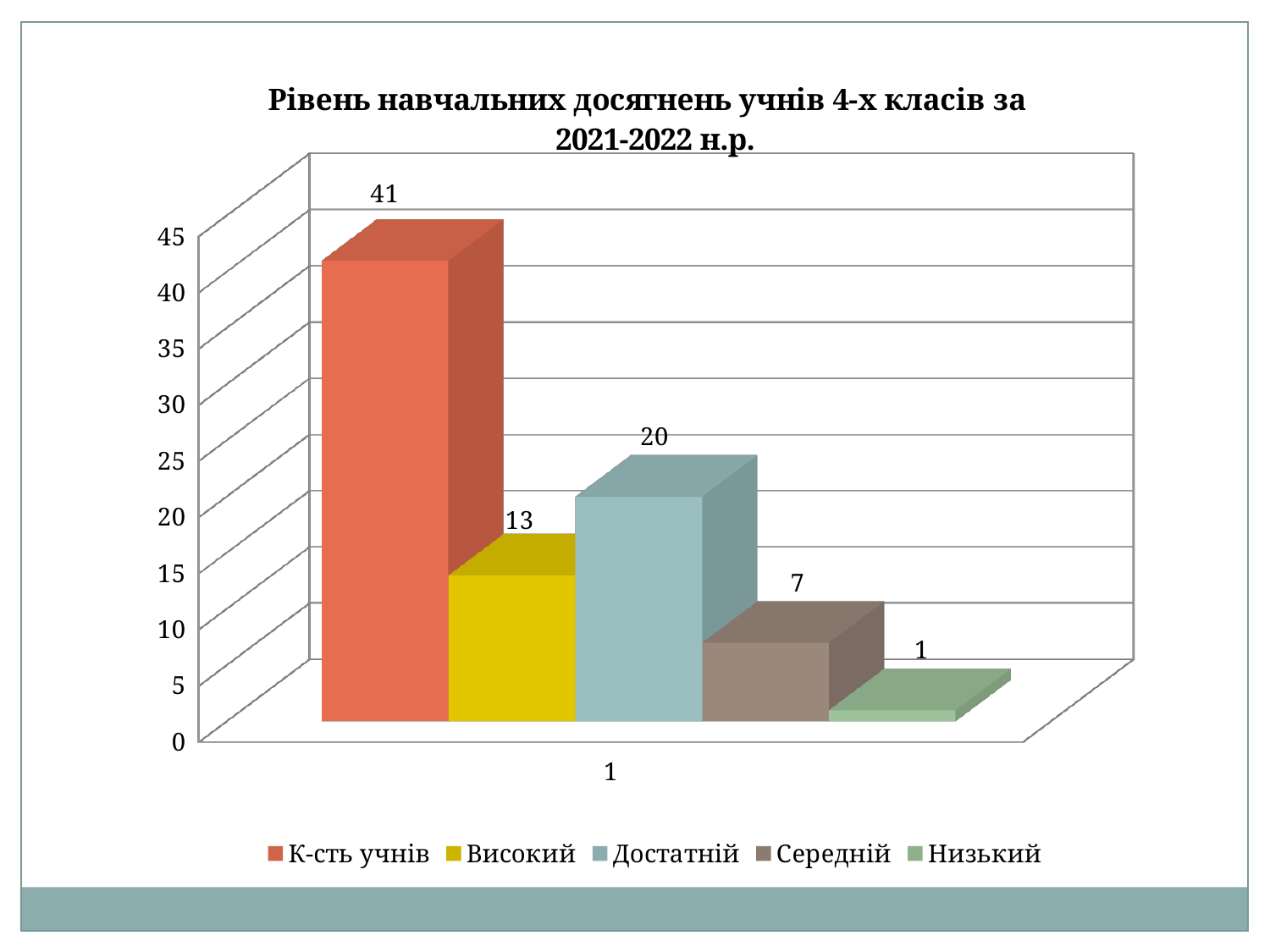
Which series has the lowest value? Низький What is the value for the series "К-сть учнів"? 41 What is the value for the series "Середній"? 7 What is the difference between the values for "Достатній" and "Високий"? 7 What is the title of the chart? Рівень навчальних досягнень учнів 4-х класів за 2021-2022 н.р. Which is larger, the value for "Високий" or the value for "Середній"? Високий Which series has the highest value? К-сть учнів How many series does the legend list? 5 What is the value for the series "Низький"? 1 What is the value for the series "Високий"? 13 What kind of chart is shown on the slide? Bar chart What is the value for the series "Достатній"? 20